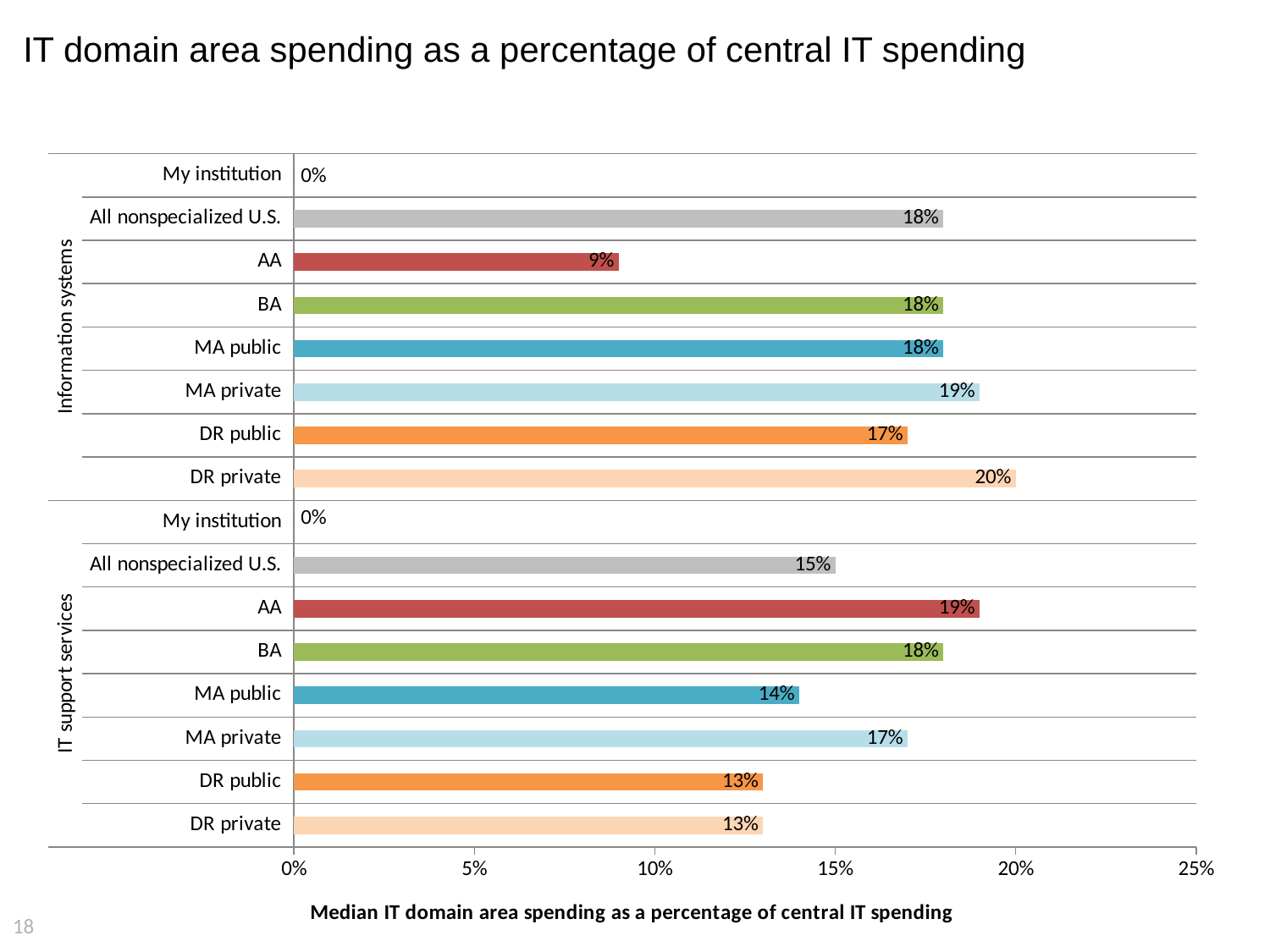
What is the value for AA under Information systems? 9% Which category has the highest value under IT support services? AA Which is larger: MA private under Information systems or MA private under IT support services? MA private under Information systems What is the x-axis title of the chart? Median IT domain area spending as a percentage of central IT spending Excluding My institution, which category has the lowest value under Information systems? AA What is the difference between DR private and AA under Information systems? 11% What is the value for DR private under Information systems? 20% What is the value for MA public under IT support services? 14% Which category has the highest value under Information systems? DR private What kind of chart is shown on the slide? Bar chart What is the difference between AA under IT support services and AA under Information systems? 10% What is the value for All nonspecialized U.S. under IT support services? 15%